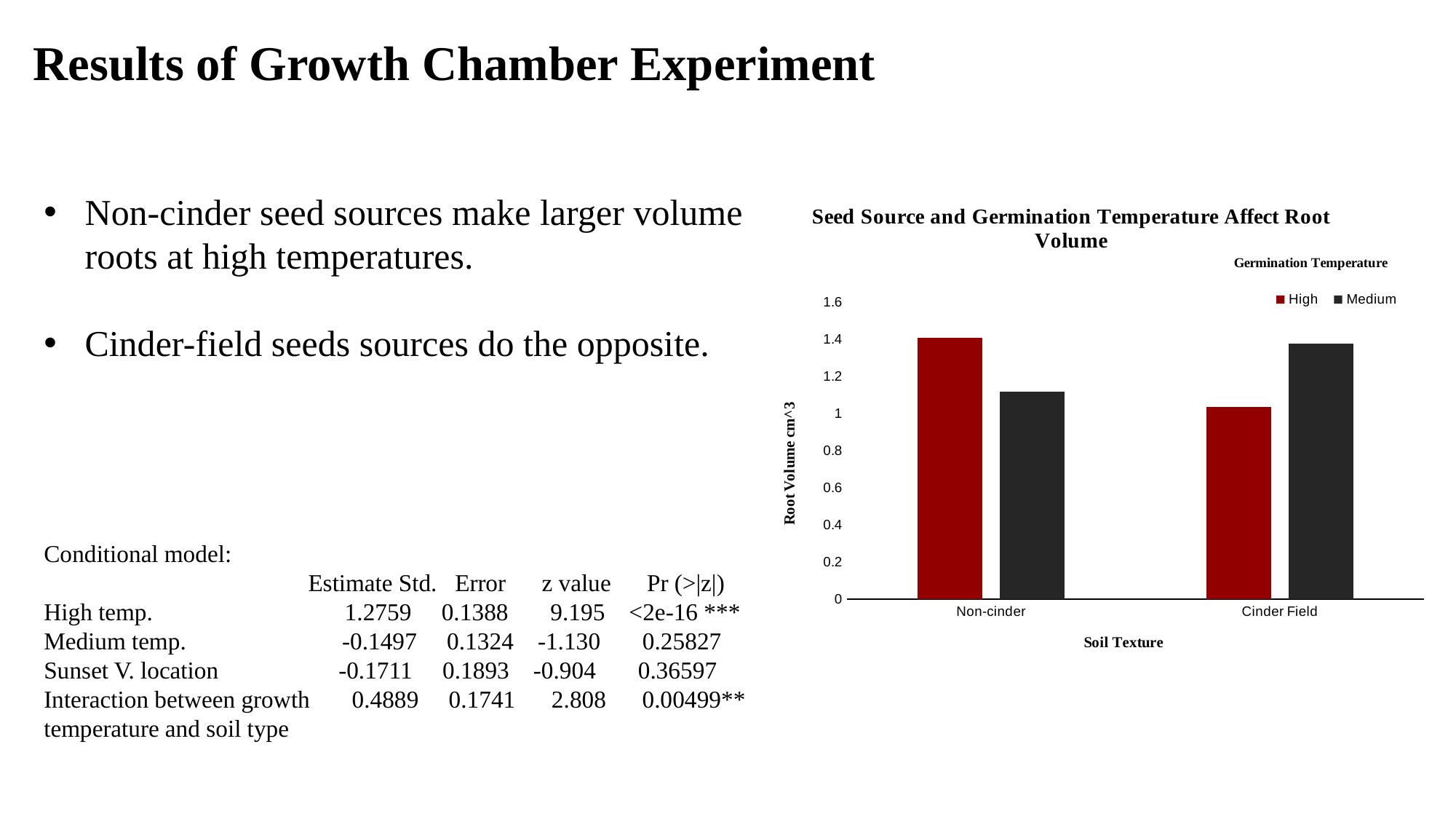
How many series does the chart legend list? 2 Which soil texture has the lowest root volume in the Medium germination temperature series? Non-cinder What type of chart is shown on the slide? bar chart Which soil texture has the highest root volume in the High germination temperature series? Non-cinder Is the root volume for Cinder Field at High germination temperature greater or less than 1.2? less Is the root volume for Non-cinder at High germination temperature greater or less than 1.2? greater How many soil texture categories are shown on the x axis of the chart? 2 For Non-cinder, which germination temperature gives the larger root volume, High or Medium? High What is the title of the chart? Seed Source and Germination Temperature Affect Root Volume What is the label of the y axis of the chart? Root Volume cm^3 For Cinder Field, which germination temperature gives the larger root volume, High or Medium? Medium Is the root volume for Cinder Field at Medium germination temperature greater or less than 1.2? greater